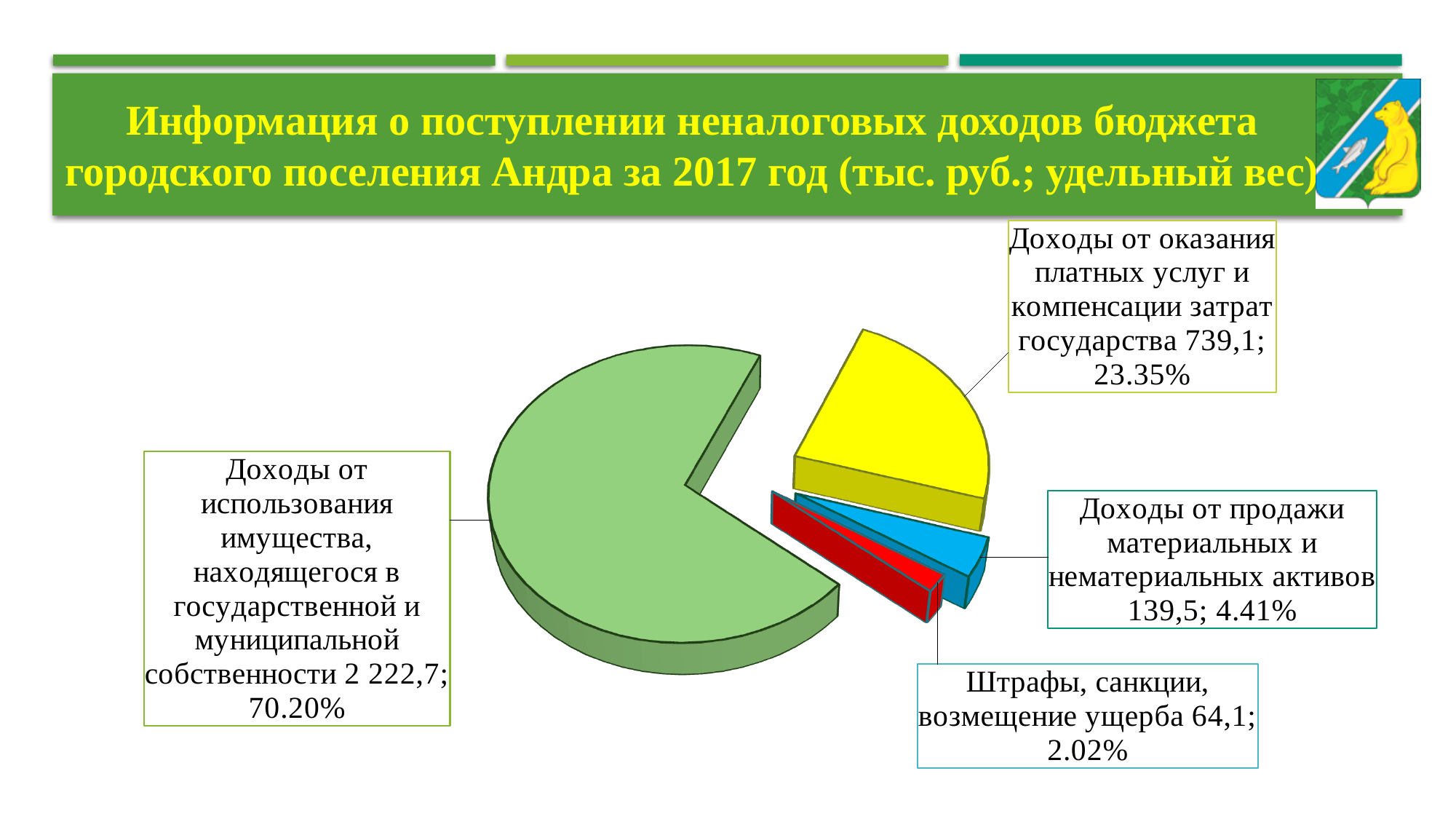
What is the difference between the value for "Доходы от оказания платных услуг и компенсации затрат государства" and the value for "Доходы от продажи материальных и нематериальных активов"? 599,6 What colour is the slice for "Доходы от оказания платных услуг и компенсации затрат государства"? Yellow How many slices does the pie chart have? 4 What is the value for "Доходы от продажи материальных и нематериальных активов"? 139,5 What is the value for "Доходы от оказания платных услуг и компенсации затрат государства"? 739,1 What share of the pie is "Доходы от использования имущества, находящегося в государственной и муниципальной собственности"? 70.20% What kind of chart is shown on the slide? Pie chart What is the difference in percentage points between the share of "Доходы от использования имущества" (70.20%) and the share of "Доходы от оказания платных услуг" (23.35%)? 46.85 Which category has the largest slice of the pie? Доходы от использования имущества, находящегося в государственной и муниципальной собственности Which category has the smallest slice of the pie? Штрафы, санкции, возмещение ущерба What share of the pie is "Штрафы, санкции, возмещение ущерба"? 2.02% Which is larger: the value for "Доходы от продажи материальных и нематериальных активов" or the value for "Штрафы, санкции, возмещение ущерба"? Доходы от продажи материальных и нематериальных активов